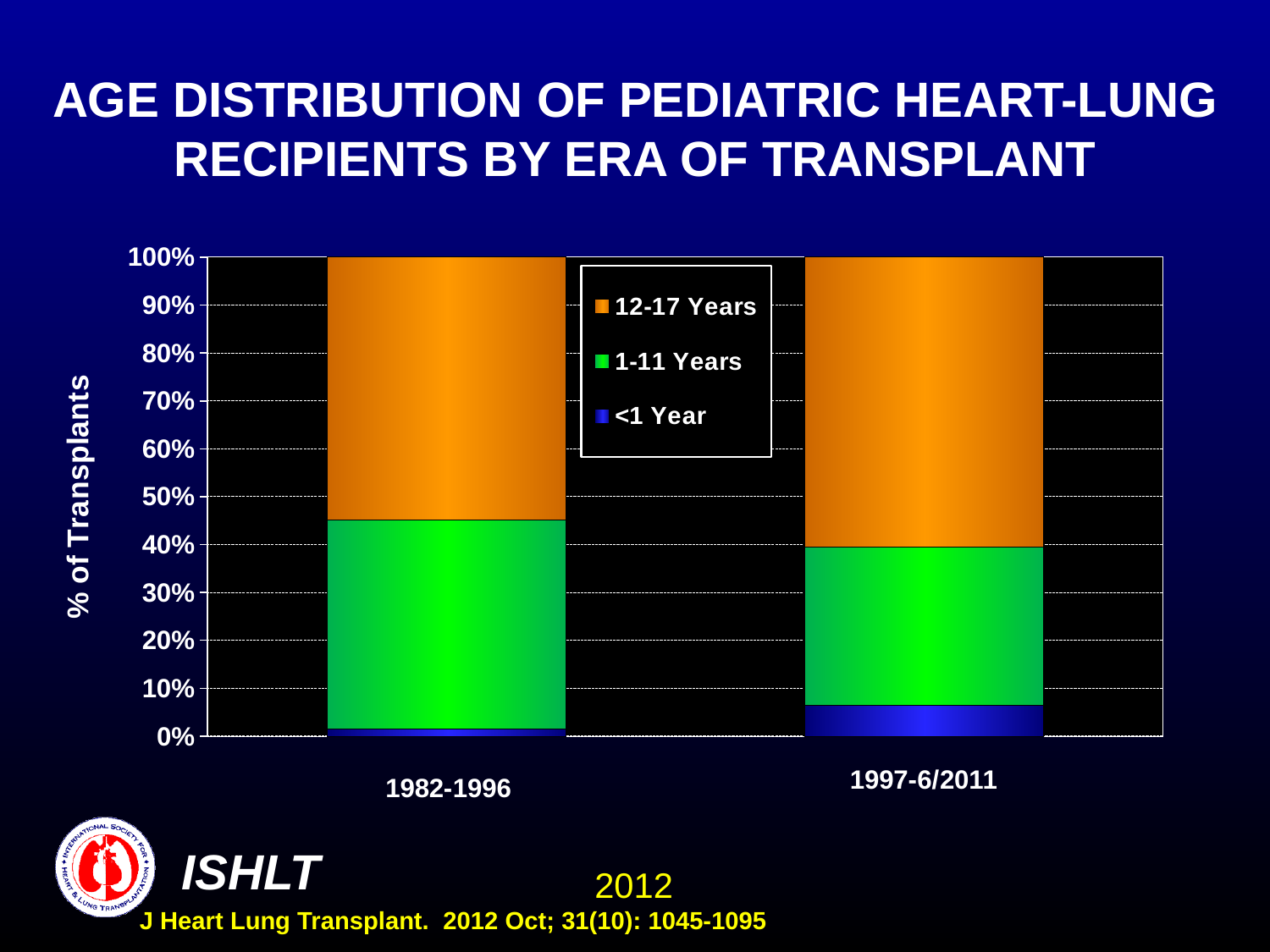
Is the share of 12-17 Years recipients in 1982-1996 greater or less than 50%? greater What is the total of the stacked bar for 1982-1996? 100% Which era has the larger share of 1-11 Years recipients, 1982-1996 or 1997-6/2011? 1982-1996 How many era categories are shown on the x axis? 2 Which era has the larger share of <1 Year recipients, 1982-1996 or 1997-6/2011? 1997-6/2011 Which age group is shown in orange in the legend? 12-17 Years What is the label of the y axis? % of Transplants Is the share of <1 Year recipients in 1997-6/2011 greater or less than 10%? less What kind of chart is shown on the slide? Stacked bar chart Is the share of 1-11 Years recipients in 1997-6/2011 greater or less than 40%? less Does the share of 12-17 Years recipients rise or fall from 1982-1996 to 1997-6/2011? rise How many series does the legend list? 3